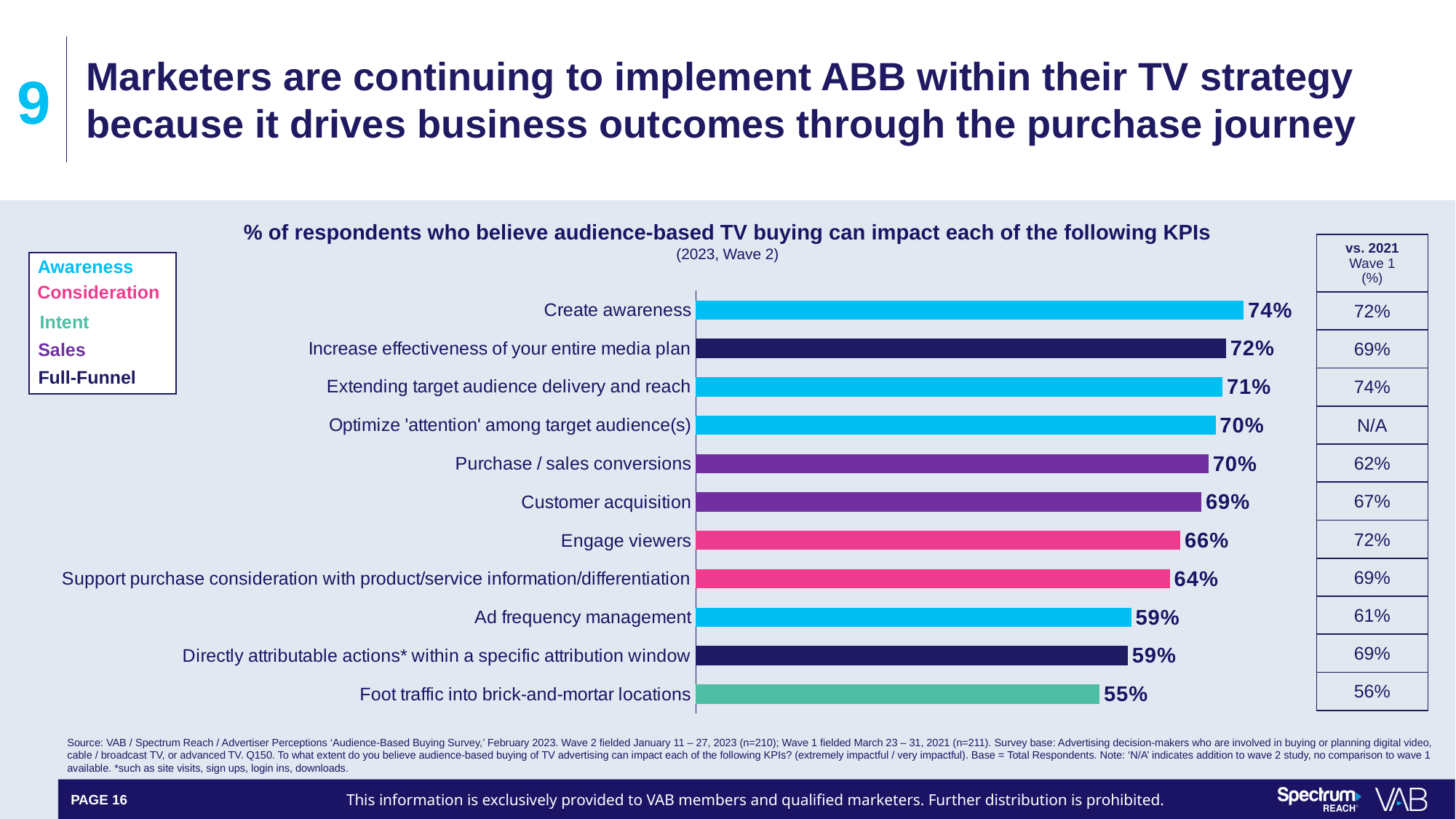
What is the difference between the values for 'Create awareness' and 'Foot traffic into brick-and-mortar locations'? 19% Which legend category does the colour of the 'Foot traffic into brick-and-mortar locations' bar correspond to? Intent Which has a larger value: 'Engage viewers' or 'Ad frequency management'? Engage viewers What is the difference between the 2023 value and the 2021 Wave 1 value for 'Purchase / sales conversions'? 8% What is the value shown for 'Customer acquisition'? 69% What kind of chart is shown on the slide? Bar chart Which KPI has the lowest percentage in the chart? Foot traffic into brick-and-mortar locations What is the value shown for 'Foot traffic into brick-and-mortar locations'? 55% How many categories does the colour legend on the left list? 5 What percentage of respondents believe audience-based TV buying can impact 'Create awareness'? 74% Which KPI has the highest percentage in the chart? Create awareness How many KPIs are plotted in the chart? 11